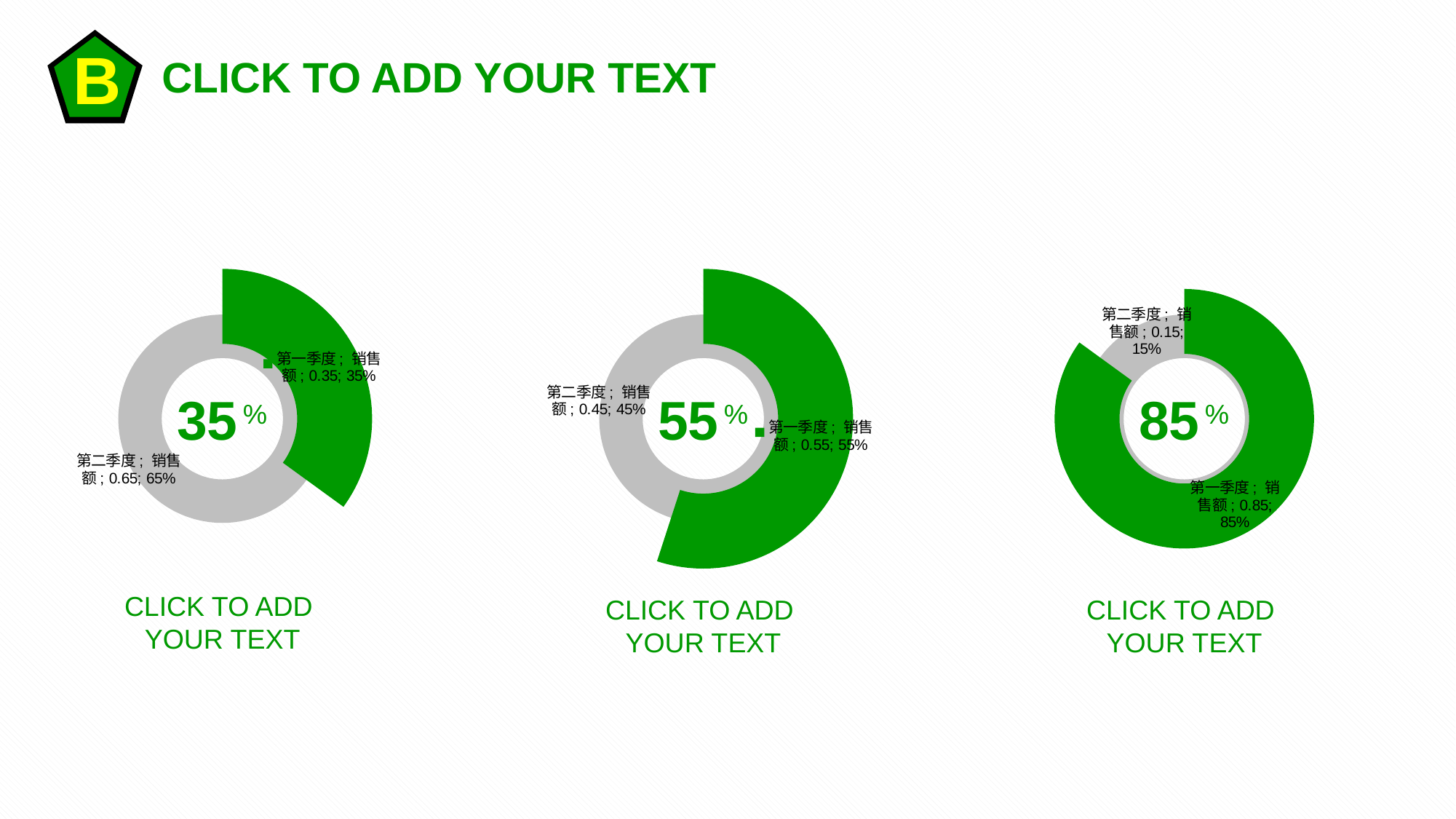
In the middle chart, what share does 第二季度 have? 45% In the middle chart, what is the value shown for 第一季度? 0.55 In the left chart, what share does 第一季度 have? 35% In the right chart, what share does 第一季度 have? 85% In the right chart, what is the value shown for 第二季度? 0.15 What kind of chart is the left chart? Doughnut chart In the left chart, what is the value shown for 第二季度? 0.65 In the left chart, which category has the larger share, 第一季度 or 第二季度? 第二季度 In the right chart, what is the difference between the shares of 第一季度 and 第二季度? 70% In the right chart, which category has the smallest share? 第二季度 In the middle chart, which category has the largest share? 第一季度 How many slices does the middle chart have? 2